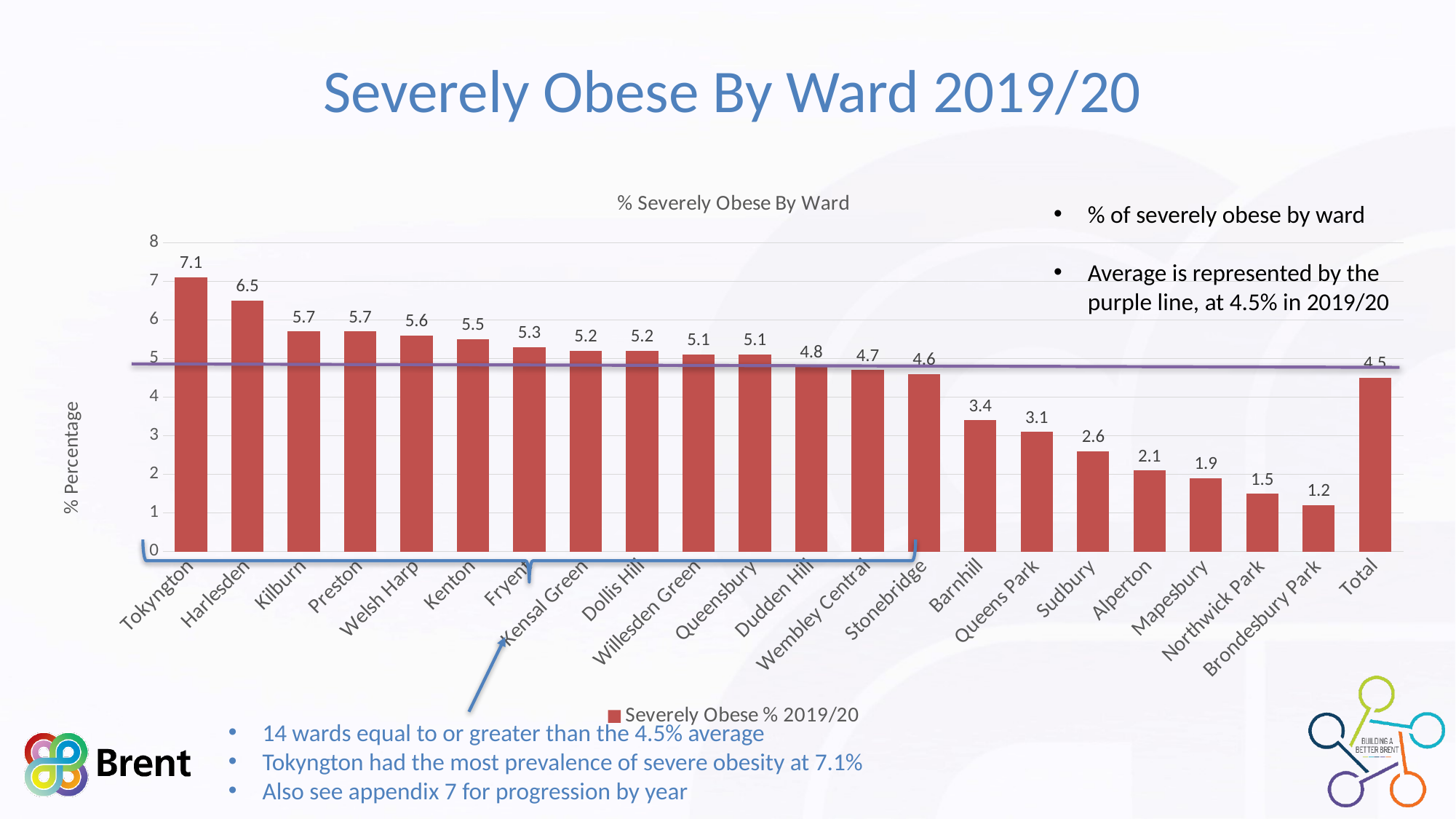
What is the value for Tokyngton? 7.1 What is the value for Barnhill? 3.4 What is the value for Harlesden? 6.5 What kind of chart is this? bar chart Which ward has the lowest value? Brondesbury Park Which is larger, the value for Sudbury or the value for Alperton? Sudbury How many bars are plotted on the chart, including Total? 22 What is the value for Brondesbury Park? 1.2 What is the title of the chart? % Severely Obese By Ward Is the value for Queens Park greater or less than 4? less Which ward has the highest value? Tokyngton What is the difference between the values for Tokyngton and Harlesden? 0.6